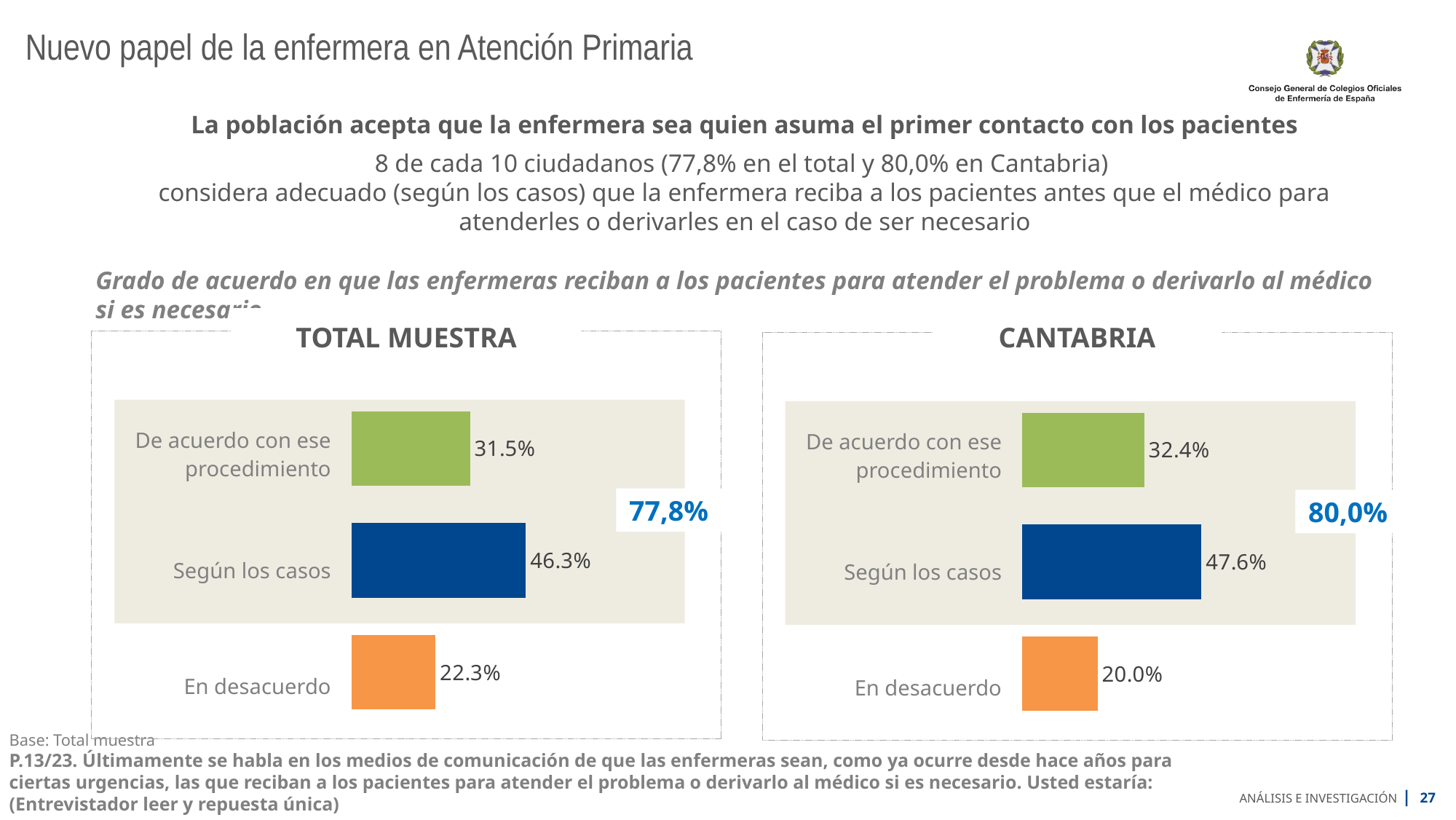
In the TOTAL MUESTRA chart, which category has the highest value? Según los casos In the CANTABRIA chart, what colour is the bar for "Según los casos"? Dark blue In the CANTABRIA chart, what is the value for "De acuerdo con ese procedimiento"? 32.4% In the TOTAL MUESTRA chart, what is the value for "Según los casos"? 46.3% In the CANTABRIA chart, what is the value for "En desacuerdo"? 20.0% How many categories does the TOTAL MUESTRA chart show? 3 In the CANTABRIA chart, which category has the lowest value? En desacuerdo In the TOTAL MUESTRA chart, what combined percentage is highlighted for the first two categories? 77,8% In the CANTABRIA chart, what is the difference between "Según los casos" and "En desacuerdo"? 27.6% In the TOTAL MUESTRA chart, what is the difference between "Según los casos" and "De acuerdo con ese procedimiento"? 14.8% What kind of chart is the CANTABRIA chart? Bar chart Which is larger: "En desacuerdo" in the TOTAL MUESTRA chart or "En desacuerdo" in the CANTABRIA chart? TOTAL MUESTRA